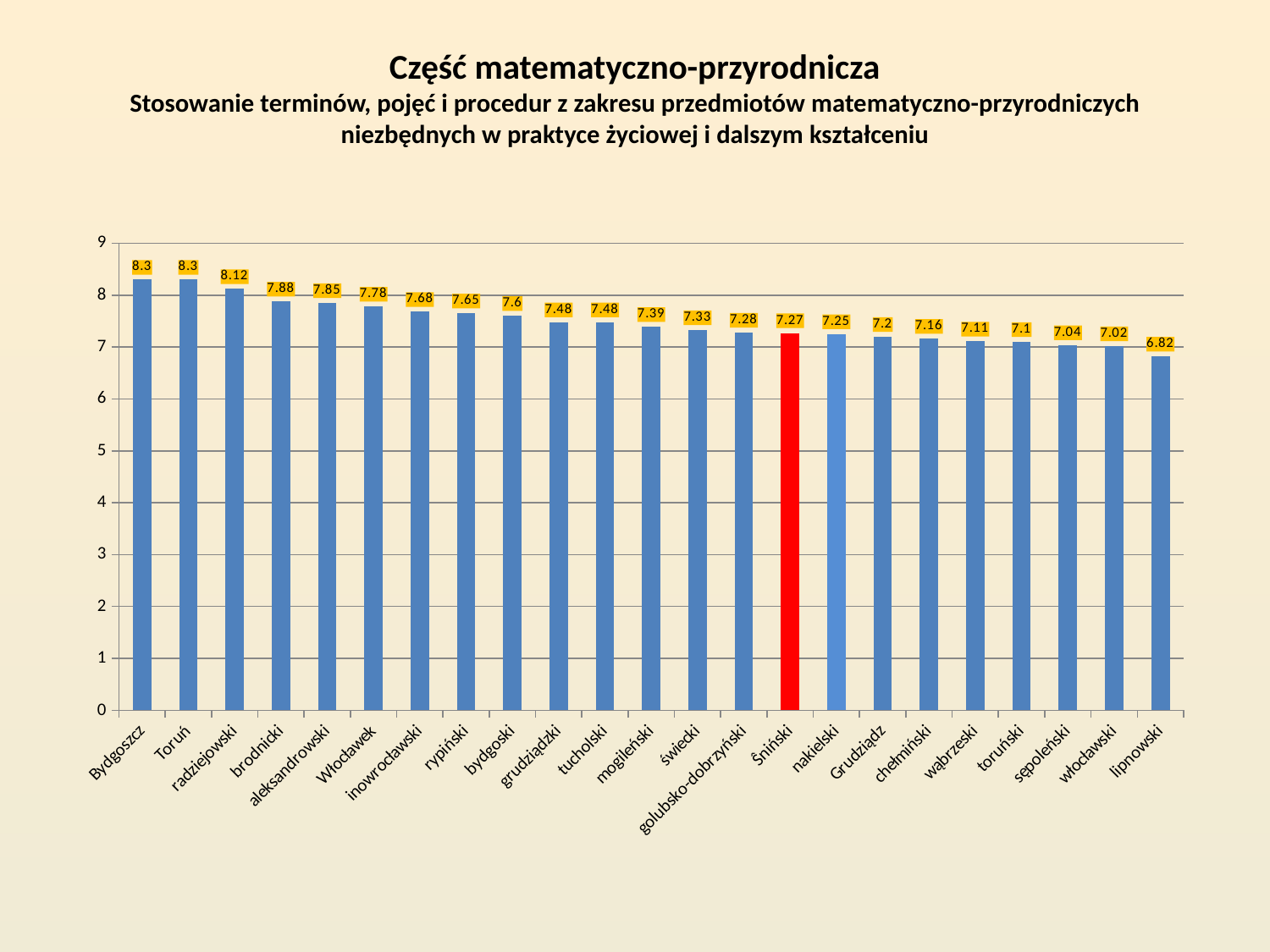
Which is larger, the value for inowrocławski or the value for nakielski? inowrocławski Which category is drawn with a red bar? Śniński Is the value for lipnowski greater or less than 7? less What is the value for lipnowski? 6.82 How many categories are shown on the x axis? 23 What kind of chart is shown on the slide? bar chart What is the value for Śniński, the red bar? 7.27 What is the difference between the values for Bydgoszcz and lipnowski? 1.48 What is the value for radziejowski? 8.12 What is the difference between the values for brodnicki and Grudziądz? 0.68 What is the value for Włocławek? 7.78 Which category has the lowest value? lipnowski